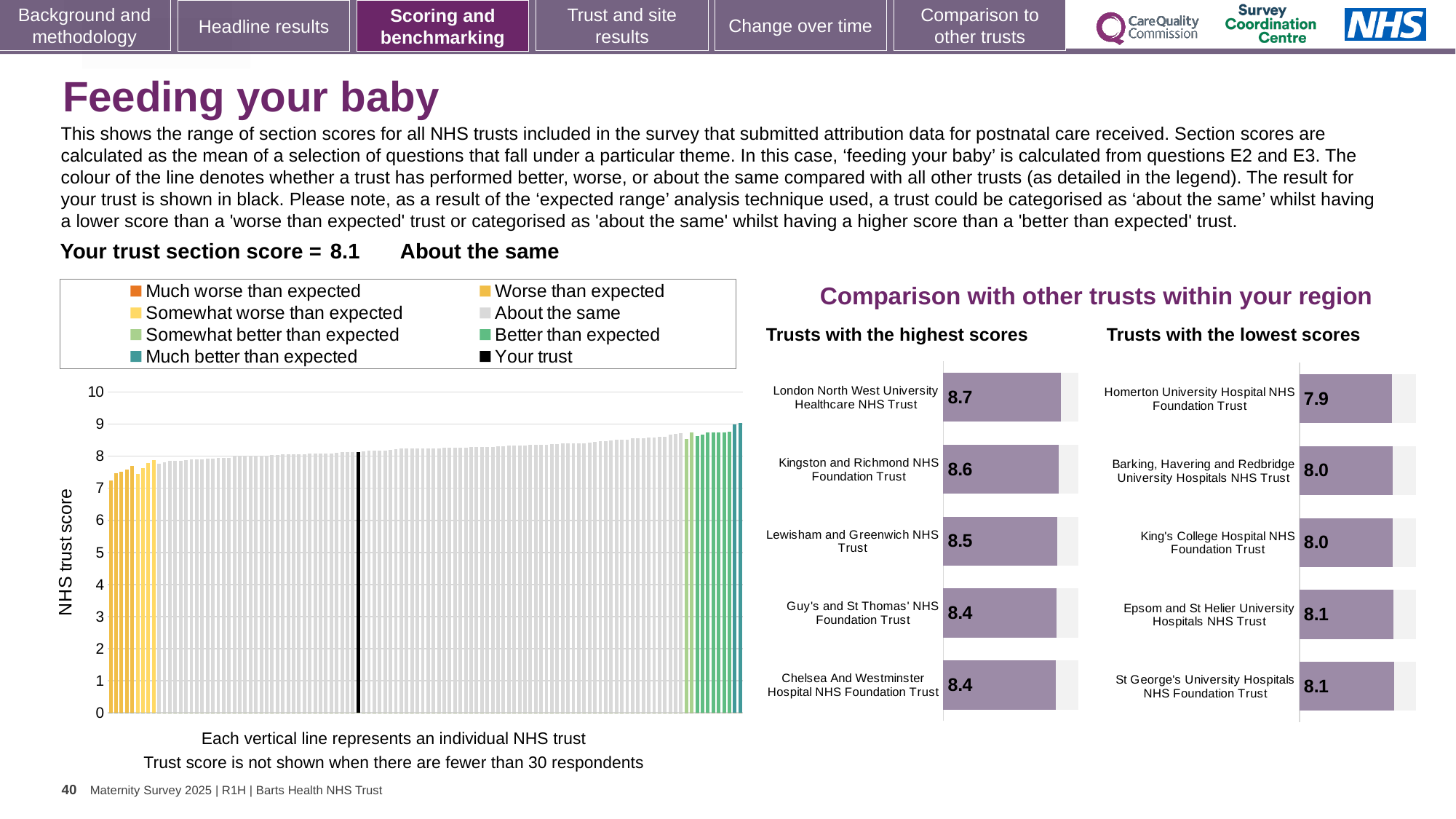
In the 'Trusts with the lowest scores' chart, what is the score for Epsom and St Helier University Hospitals NHS Trust? 8.1 In the 'Trusts with the highest scores' chart, which has the higher score: Kingston and Richmond NHS Foundation Trust or Guy's and St Thomas' NHS Foundation Trust? Kingston and Richmond NHS Foundation Trust In the 'NHS trust score' chart, do the bar values rise or fall from left to right? Rise In the 'Trusts with the highest scores' chart, what is the score for London North West University Healthcare NHS Trust? 8.7 In the 'NHS trust score' chart, is the value of the leftmost (lowest) bar greater or less than 8? less What kind of chart is the 'NHS trust score' chart on the left? Bar chart In the 'Trusts with the lowest scores' chart, which trust has the lowest score? Homerton University Hospital NHS Foundation Trust How many entries does the legend of the 'NHS trust score' chart list? 8 In the 'Trusts with the lowest scores' chart, what is the score for Homerton University Hospital NHS Foundation Trust? 7.9 In the 'Trusts with the highest scores' chart, which trust has the highest score? London North West University Healthcare NHS Trust How many trusts are shown in the 'Trusts with the lowest scores' chart? 5 In the 'Trusts with the highest scores' chart, what is the difference between the scores of London North West University Healthcare NHS Trust and Lewisham and Greenwich NHS Trust? 0.2